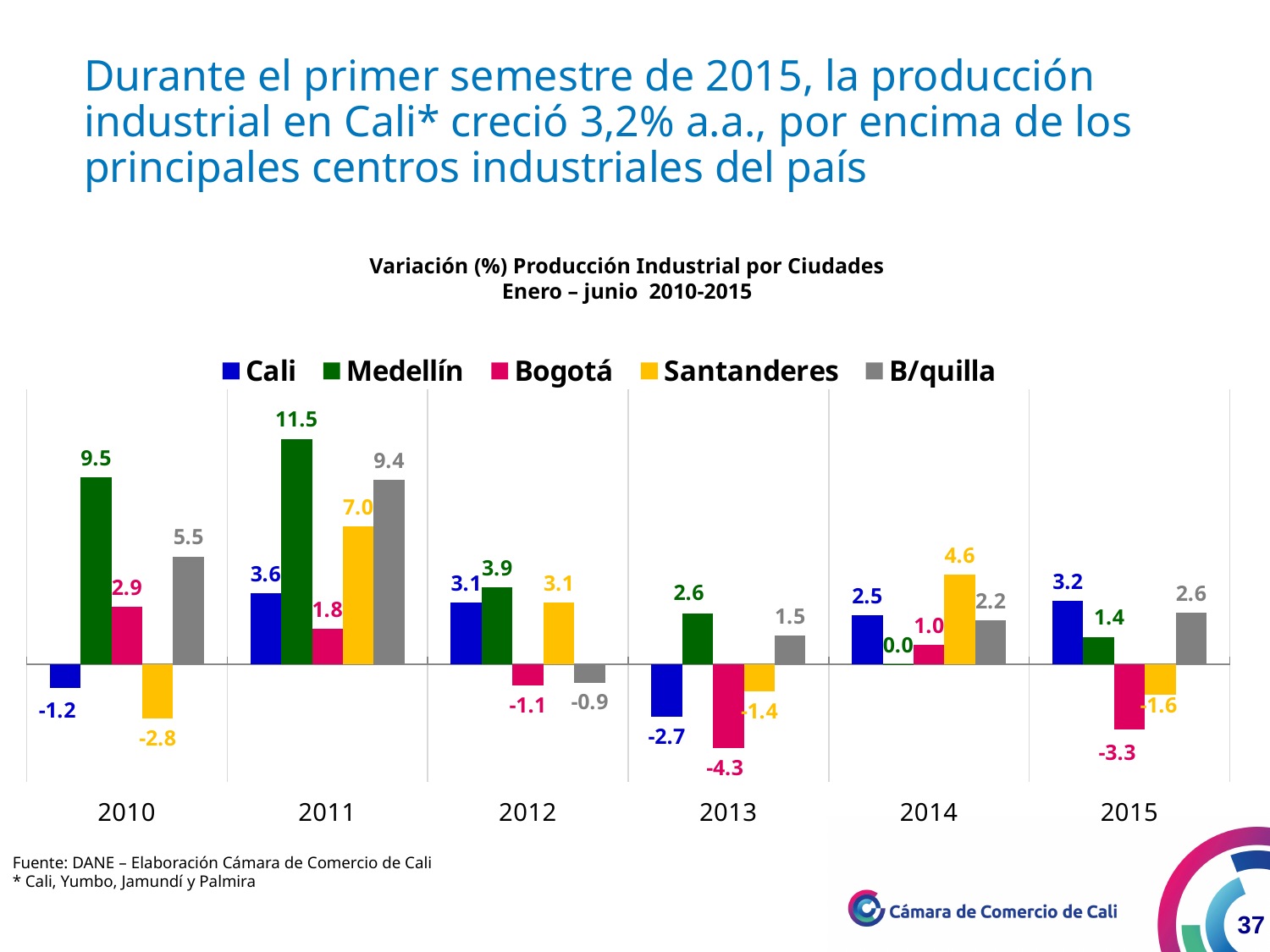
What is the value for Santanderes in 2014? 4.6 Which series is shown in yellow in the legend? Santanderes What is the value for Cali in 2015? 3.2 Which city has the lowest value in 2015? Bogotá What kind of chart is shown on the slide? Bar chart Which city has the highest value in 2010? Medellín How many years are shown on the x axis? 6 Which is larger in 2012, the value for Cali or the value for Santanderes? Neither; they are equal (both 3.1) What is the value for Medellín in 2011? 11.5 How many series does the legend list? 5 What is the difference between the Medellín and Cali values in 2011? 7.9 What is the value for Bogotá in 2013? -4.3